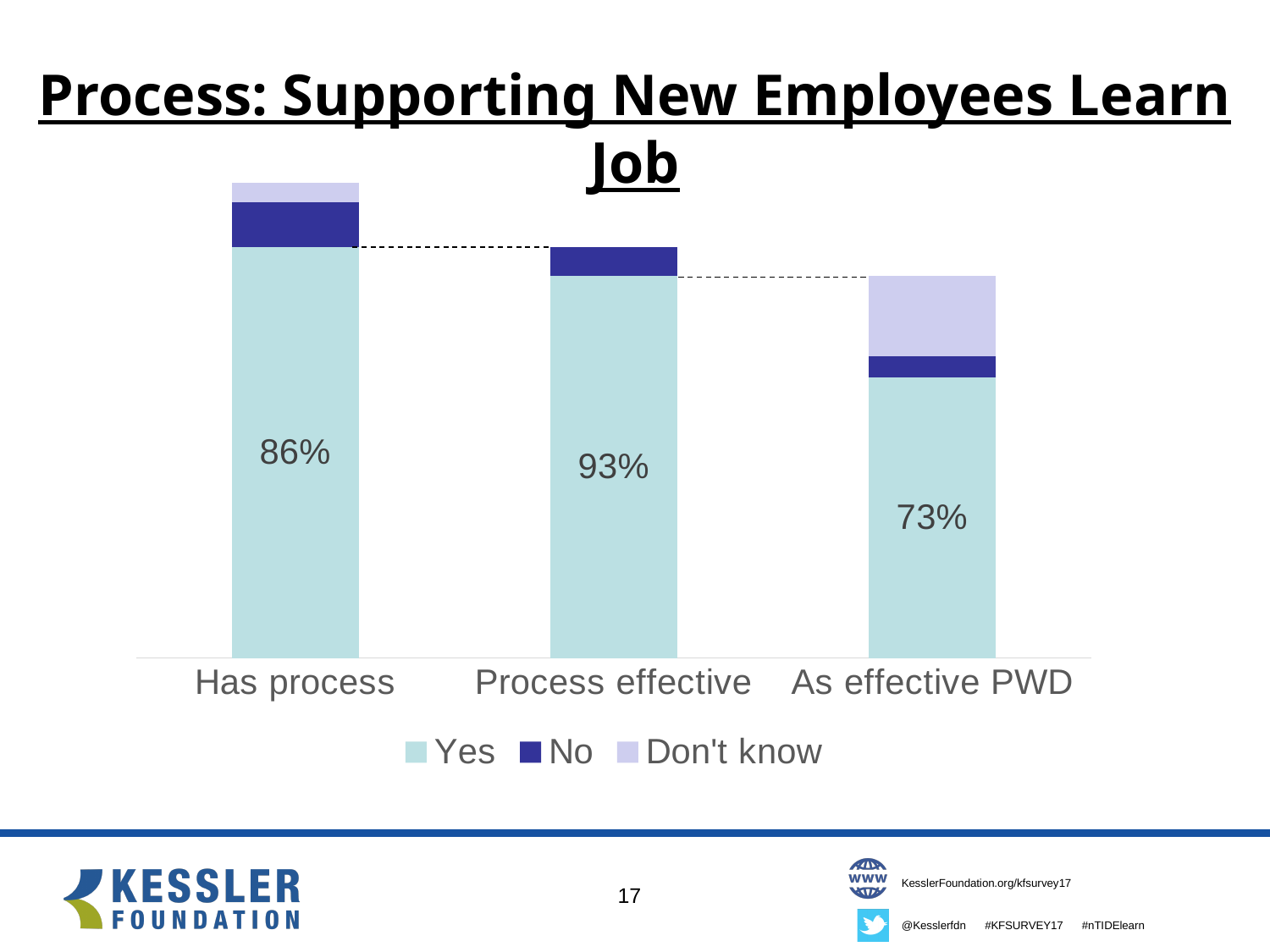
What is the difference between the "Yes" values for "Has process" and "As effective PWD"? 13 percentage points How many categories are shown on the x axis? 3 What is the "Yes" value for "Has process"? 86% What is the "Yes" value for "As effective PWD"? 73% How many series does the legend list? 3 What is the difference between the "Yes" values for "Process effective" and "Has process"? 7 percentage points Which category has the lowest "Yes" value? As effective PWD What are the three entries in the chart legend? Yes, No, Don't know Which category has the highest "Yes" value? Process effective What kind of chart is shown on the slide? Stacked bar chart Which has a larger "Yes" value, "Has process" or "As effective PWD"? Has process What is the "Yes" value for "Process effective"? 93%